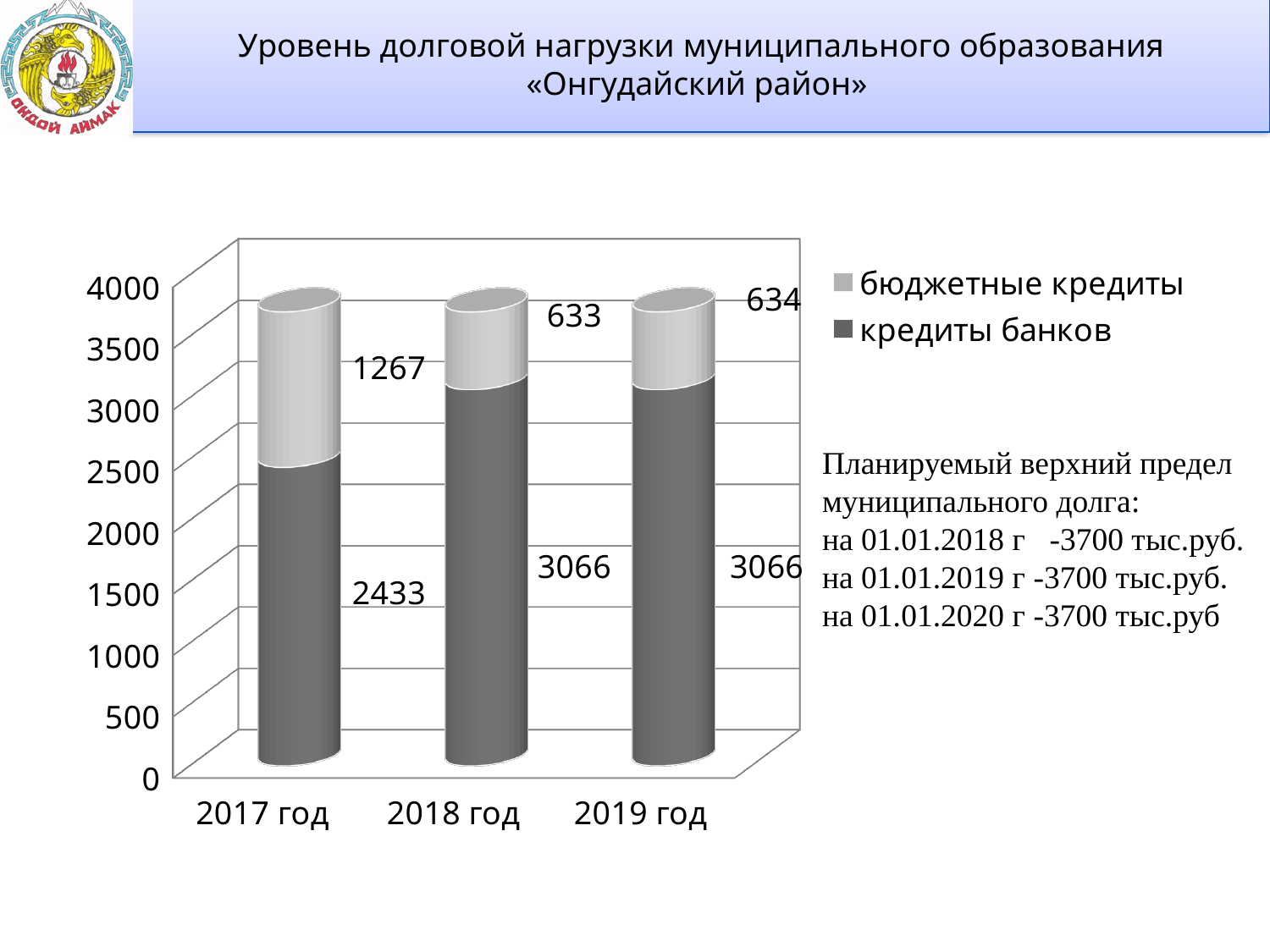
Is бюджетные кредиты larger in 2017 год or in 2018 год? 2017 год How many years are shown on the x axis? 3 How many series does the legend list? 2 What is the value of бюджетные кредиты for 2017 год? 1267 What is the difference between кредиты банков in 2018 год and in 2017 год? 633 What is the value of кредиты банков for 2018 год? 3066 Which year has the highest value for бюджетные кредиты? 2017 год What kind of chart is shown on the slide? Stacked bar chart What is the value of бюджетные кредиты for 2019 год? 634 What is the total of the stacked bar for 2017 год? 3700 Which year has the lowest value for кредиты банков? 2017 год What is the value of кредиты банков for 2017 год? 2433